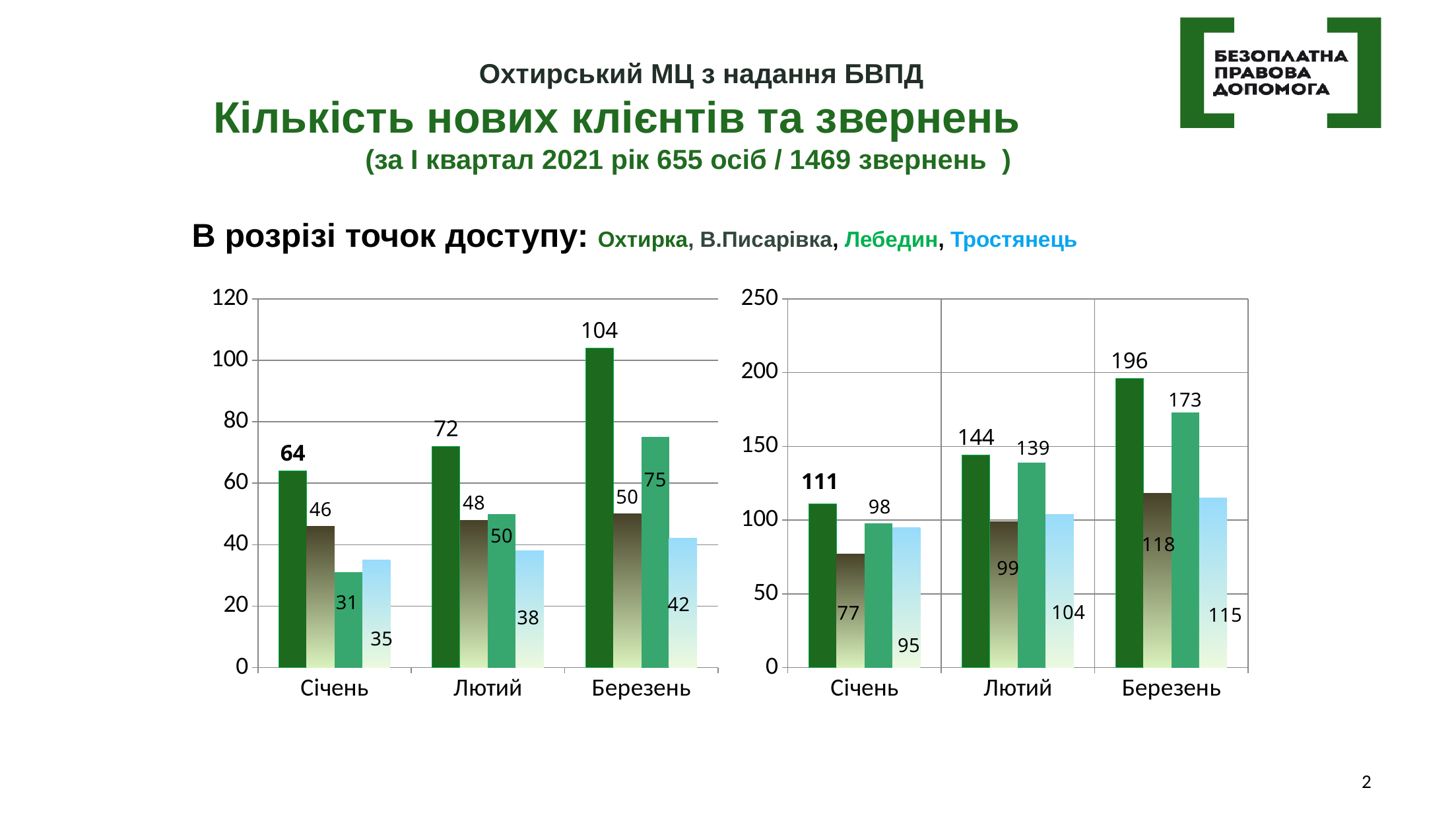
On the right chart, which month has the lowest light blue (Тростянець) bar? Січень On the right chart, what is the value of the green bar (Лебедин) for Березень? 173 How many months are shown on the x axis of the left chart? 3 On the right chart, what is the value of the dark green bar (Охтирка) for Січень? 111 What type of chart is the right chart? bar chart On the right chart, do the dark green (Охтирка) bars rise or fall from Січень to Березень? rise On the left chart, which is larger for Лютий: the dark brown bar (В.Писарівка) or the green bar (Лебедин)? Лебедин (50) On the right chart, is the value of the dark green bar (Охтирка) for Лютий greater or less than 100? greater On the left chart, what is the value of the light blue bar (Тростянець) for Лютий? 38 On the left chart, which month has the highest dark green (Охтирка) bar? Березень On the right chart, what is the difference between the dark green bar (Охтирка) and the green bar (Лебедин) for Березень? 23 On the left chart, what is the value of the dark green bar (Охтирка) for Березень? 104